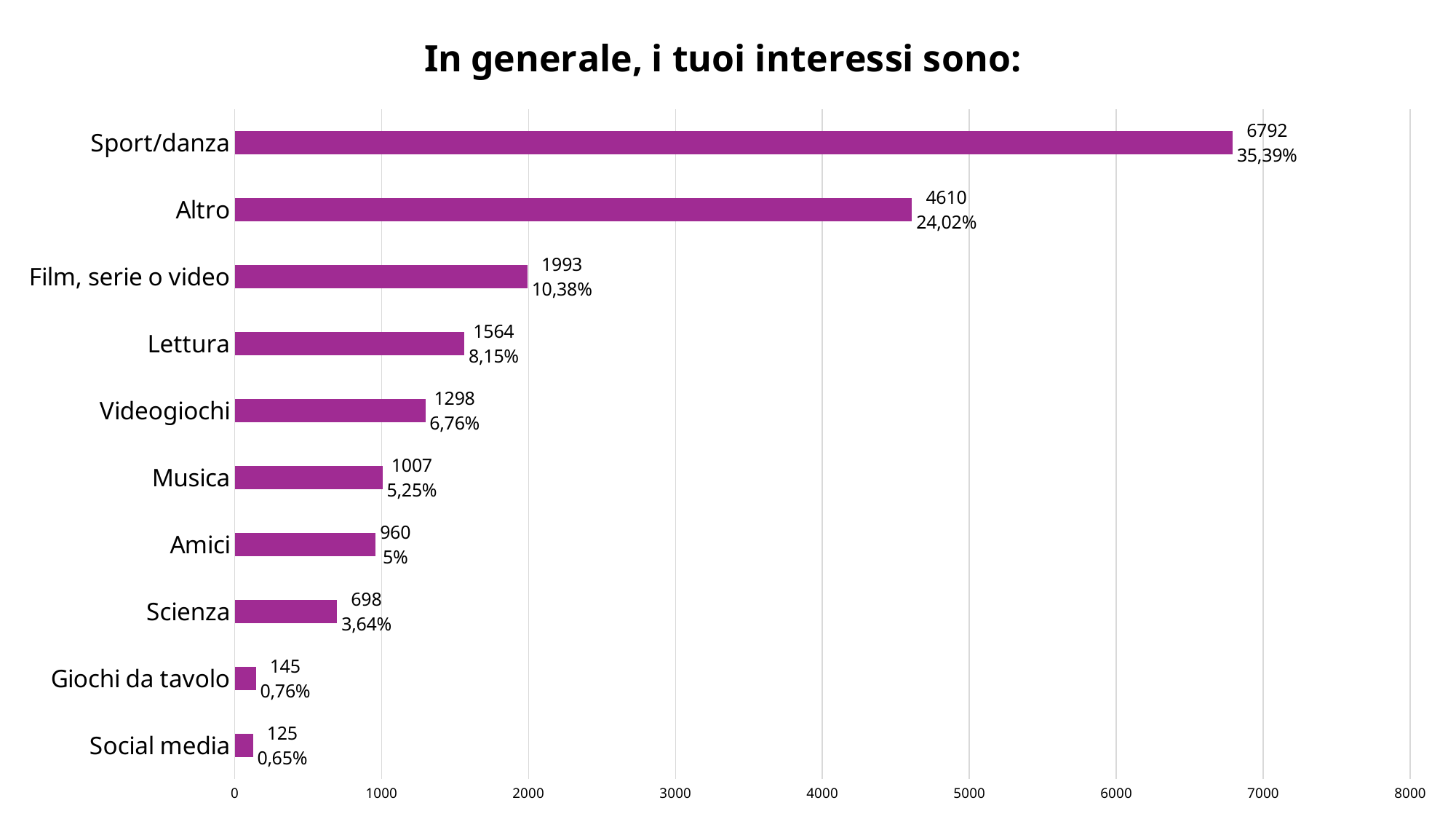
Which category has the highest value? Sport/danza What percentage is shown for Scienza? 3,64% What is the difference between the values for Sport/danza and Altro? 2182 What is the value for Lettura? 1564 What is the value for Sport/danza? 6792 Which is larger, the value for Videogiochi or the value for Musica? Videogiochi How many categories are shown in the chart? 10 What percentage is shown for Altro? 24,02% What is the title of the chart? In generale, i tuoi interessi sono: What is the difference between the values for Giochi da tavolo and Social media? 20 What kind of chart is this? Bar chart Which category has the lowest value? Social media